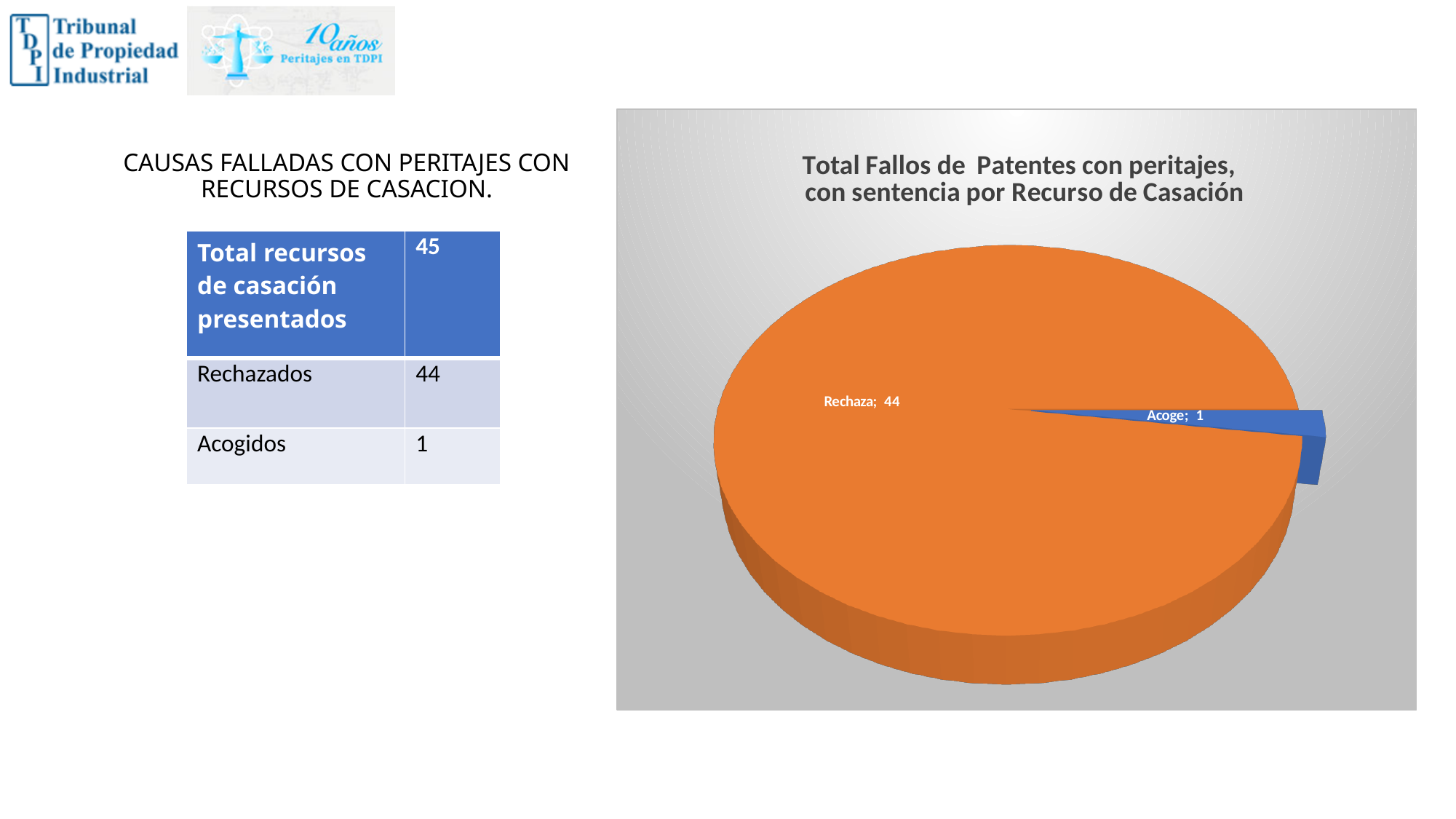
What is the total of all slices in the pie chart? 45 How many slices does the pie chart have? 2 What colour is the Rechaza slice in the pie chart? Orange What is the difference between the Rechaza and Acoge values in the pie chart? 43 What is the title of the pie chart? Total Fallos de Patentes con peritajes, con sentencia por Recurso de Casación Which slice of the pie chart is the largest? Rechaza Which slice of the pie chart is the smallest? Acoge What is the value for Rechaza in the pie chart? 44 What is the value for Acoge in the pie chart? 1 What type of chart is shown on the slide? Pie chart Which is larger in the pie chart, Rechaza or Acoge? Rechaza